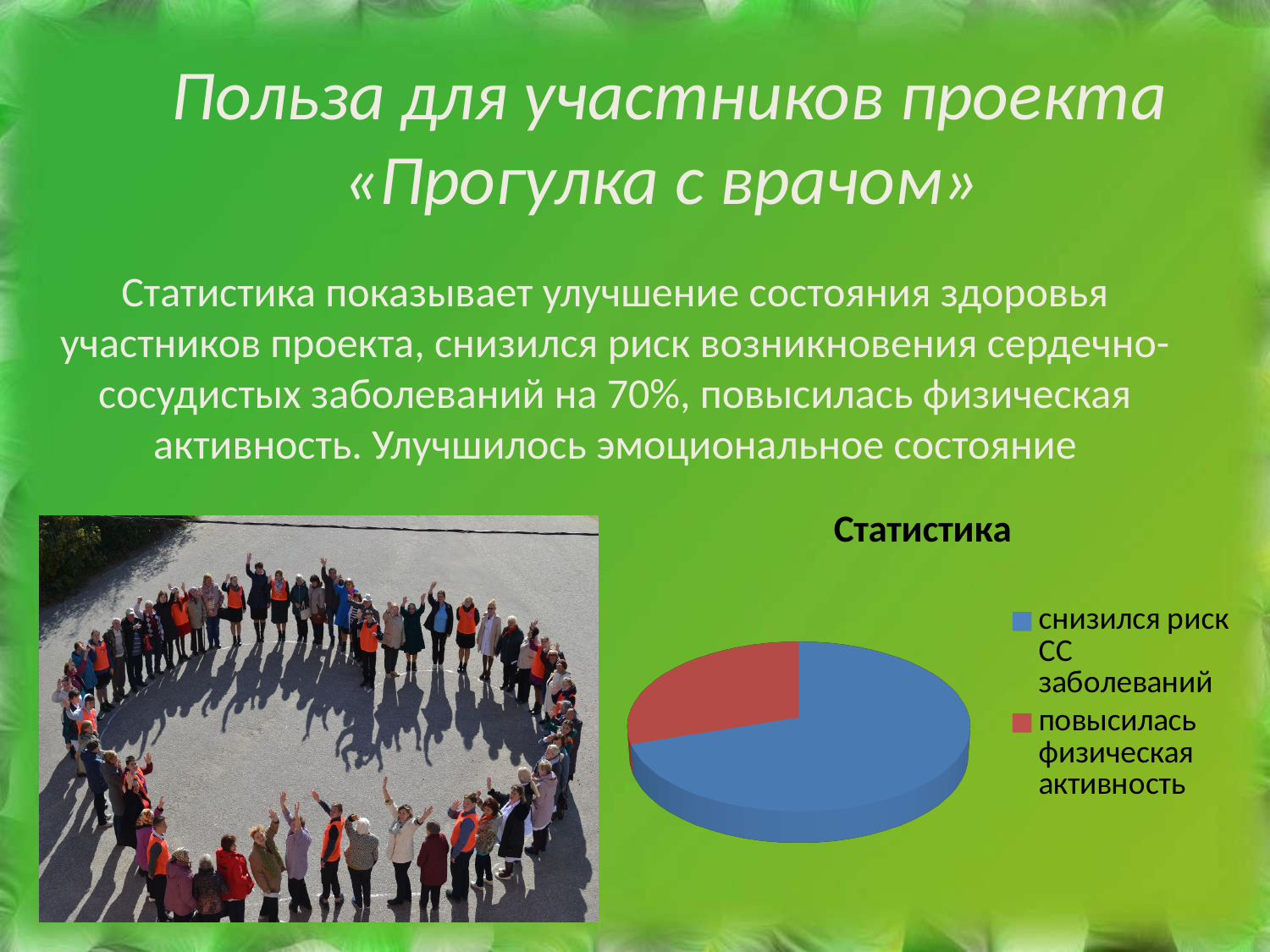
What kind of chart is shown on the slide? pie chart How many slices does the pie chart have? 2 What colour is the slice for "повысилась физическая активность"? red How many entries does the chart legend list? 2 Which is larger in the pie chart: "снизился риск СС заболеваний" or "повысилась физическая активность"? снизился риск СС заболеваний Which slice of the pie chart is the smallest? повысилась физическая активность Does the slice for "снизился риск СС заболеваний" take up more or less than half of the pie? more Which slice of the pie chart is the largest? снизился риск СС заболеваний What is the title of the chart? Статистика